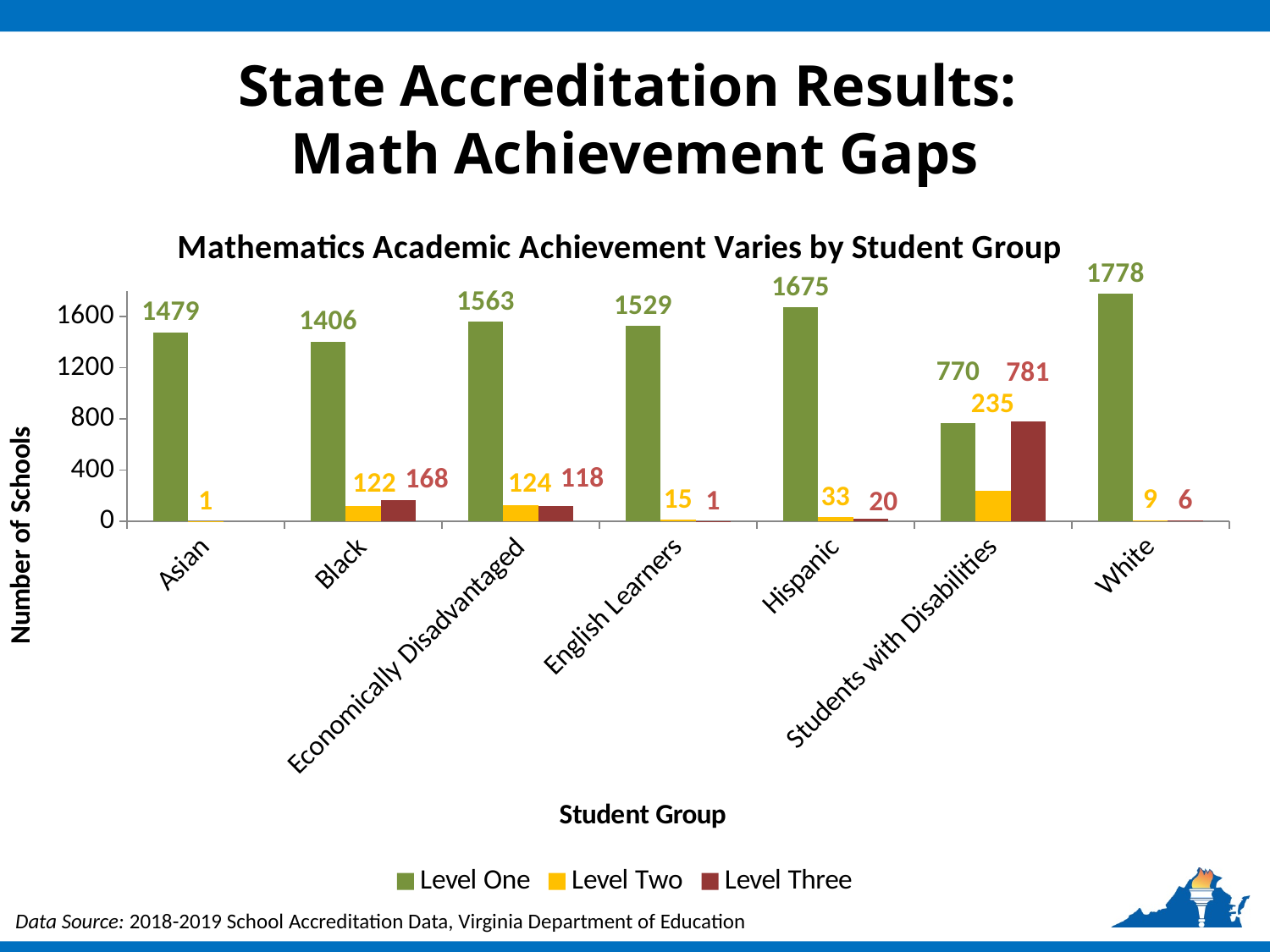
What is the Level One value for Hispanic? 1675 What is the title of the chart? Mathematics Academic Achievement Varies by Student Group How many student groups are shown on the x axis? 7 What is the Level Two value for Black? 122 Which is larger for Students with Disabilities, the Level One value or the Level Three value? Level Three How many series does the legend list? 3 What is the difference between the Level One values for White and Asian? 299 Which student group has the lowest Level One value? Students with Disabilities Which student group has the highest Level One value? White What is the Level Three value for Students with Disabilities? 781 Is the Level One value for Economically Disadvantaged greater or less than 1200? greater What kind of chart is shown on the slide? Bar chart